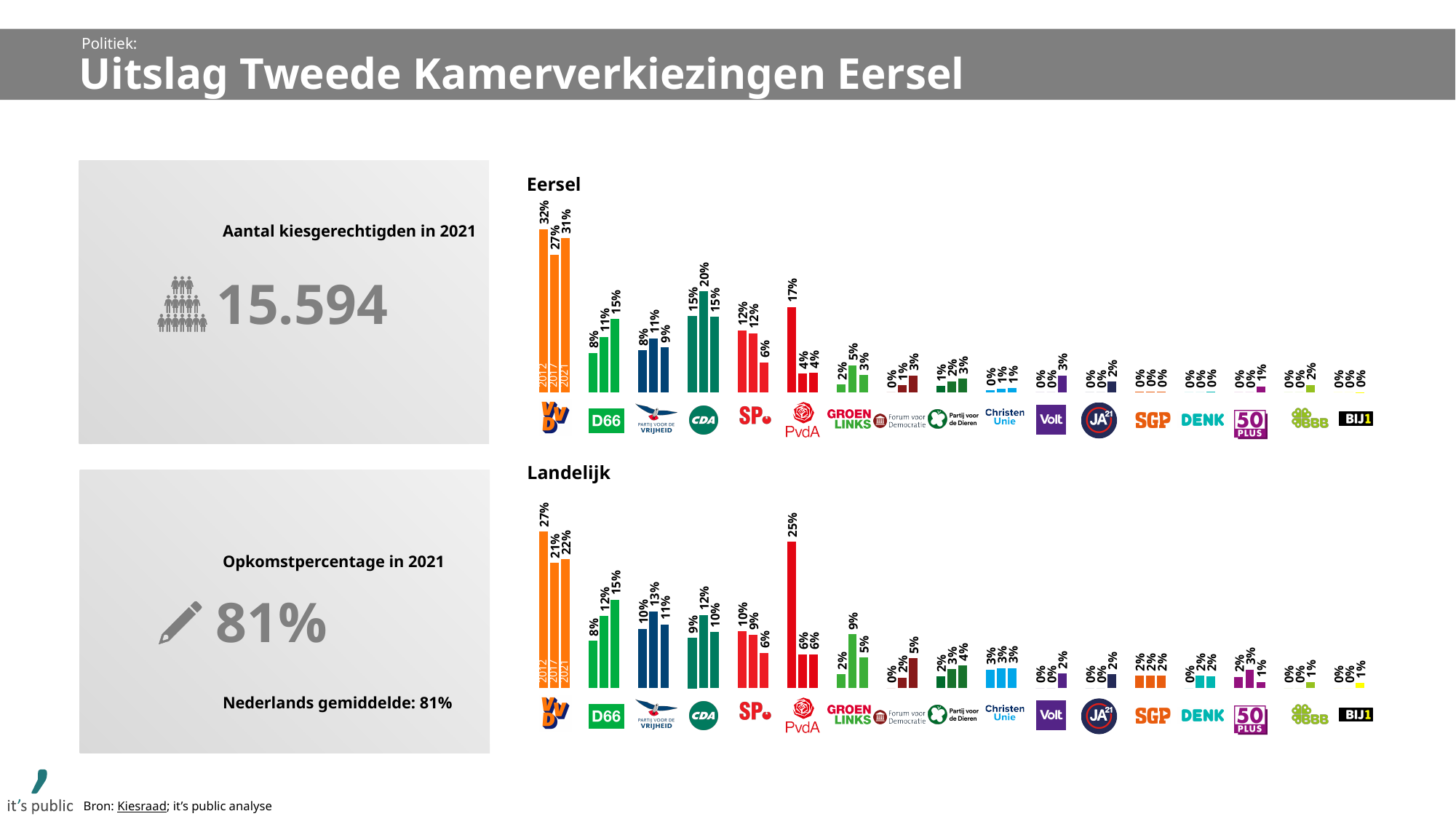
In the Eersel chart, what percentage did CDA get in 2017? 20% In the Eersel chart, which party had the highest percentage in 2021? VVD In the Landelijk chart, which is larger: GroenLinks in 2017 or CDA in 2017? CDA in 2017 In the Landelijk chart, what is the difference between PvdA's 2012 and 2017 percentages? 19% In the Eersel chart, which is larger: D66 in 2021 or PVV in 2021? D66 in 2021 How many years (series) are shown for each party in the Eersel chart? 3 In the Eersel chart, what is the difference between VVD's 2012 and 2017 percentages? 5% In the Landelijk chart, which party had the highest percentage in 2012? VVD In the Eersel chart, what percentage did VVD get in 2021? 31% What type of chart is the Landelijk chart? bar chart In the Eersel chart, do D66's values rise or fall from 2012 to 2021? rise In the Landelijk chart, what percentage did PvdA get in 2012? 25%